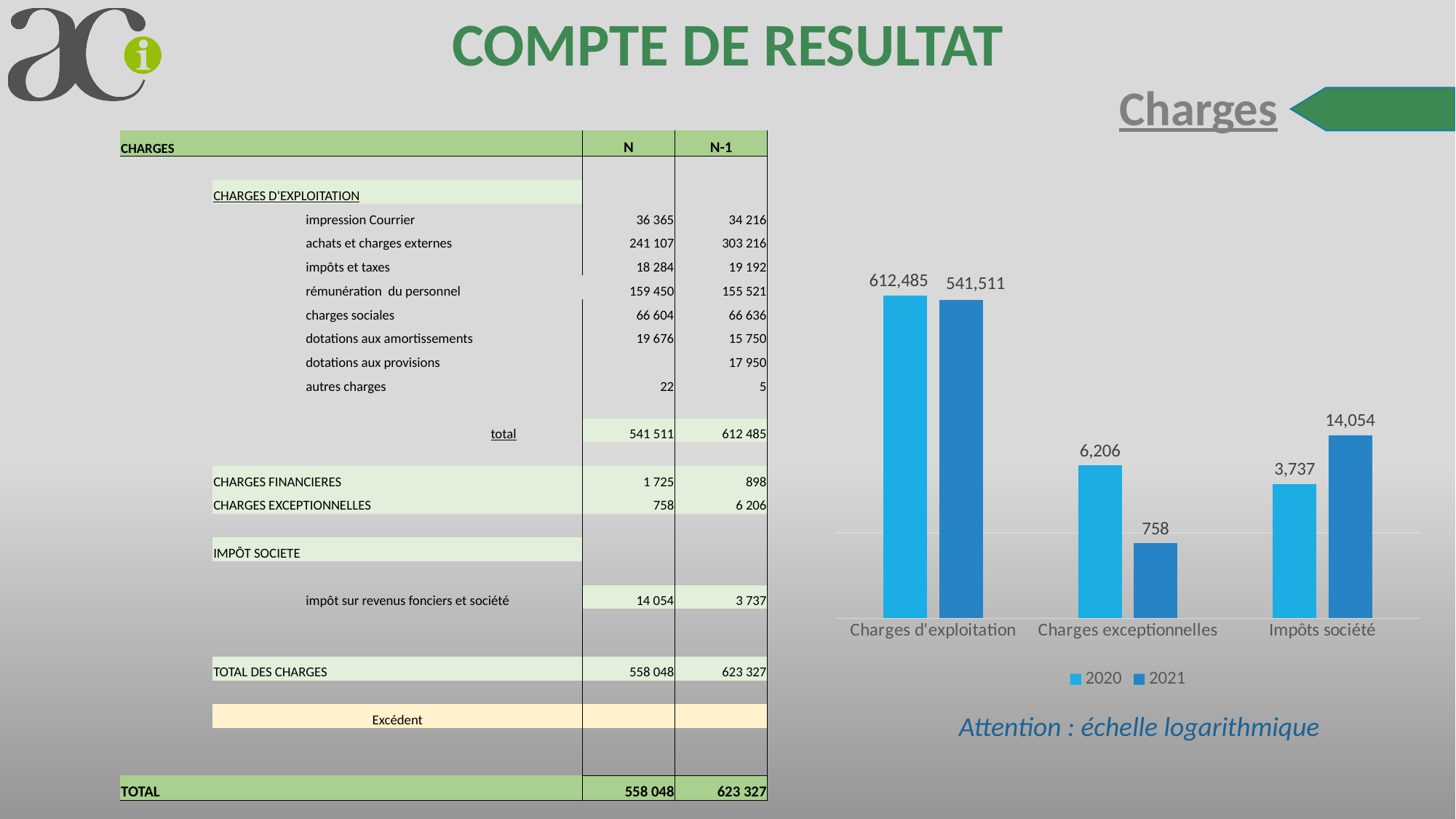
How many categories are shown on the x axis of the chart? 3 What note is written below the chart legend about the scale? Attention : échelle logarithmique For Impôts société, which series has the larger value, 2020 or 2021? 2021 What is the 2020 value for Charges d'exploitation in the chart? 612,485 What is the difference between the 2020 and 2021 values for Charges exceptionnelles? 5,448 Which category has the highest 2021 value in the chart? Charges d'exploitation What is the 2021 value for Charges d'exploitation in the chart? 541,511 What is the 2021 value for Charges exceptionnelles in the chart? 758 What type of chart is shown on the slide? bar chart Which category has the lowest 2021 value in the chart? Charges exceptionnelles How many series does the chart legend list? 2 What is the 2020 value for Impôts société in the chart? 3,737